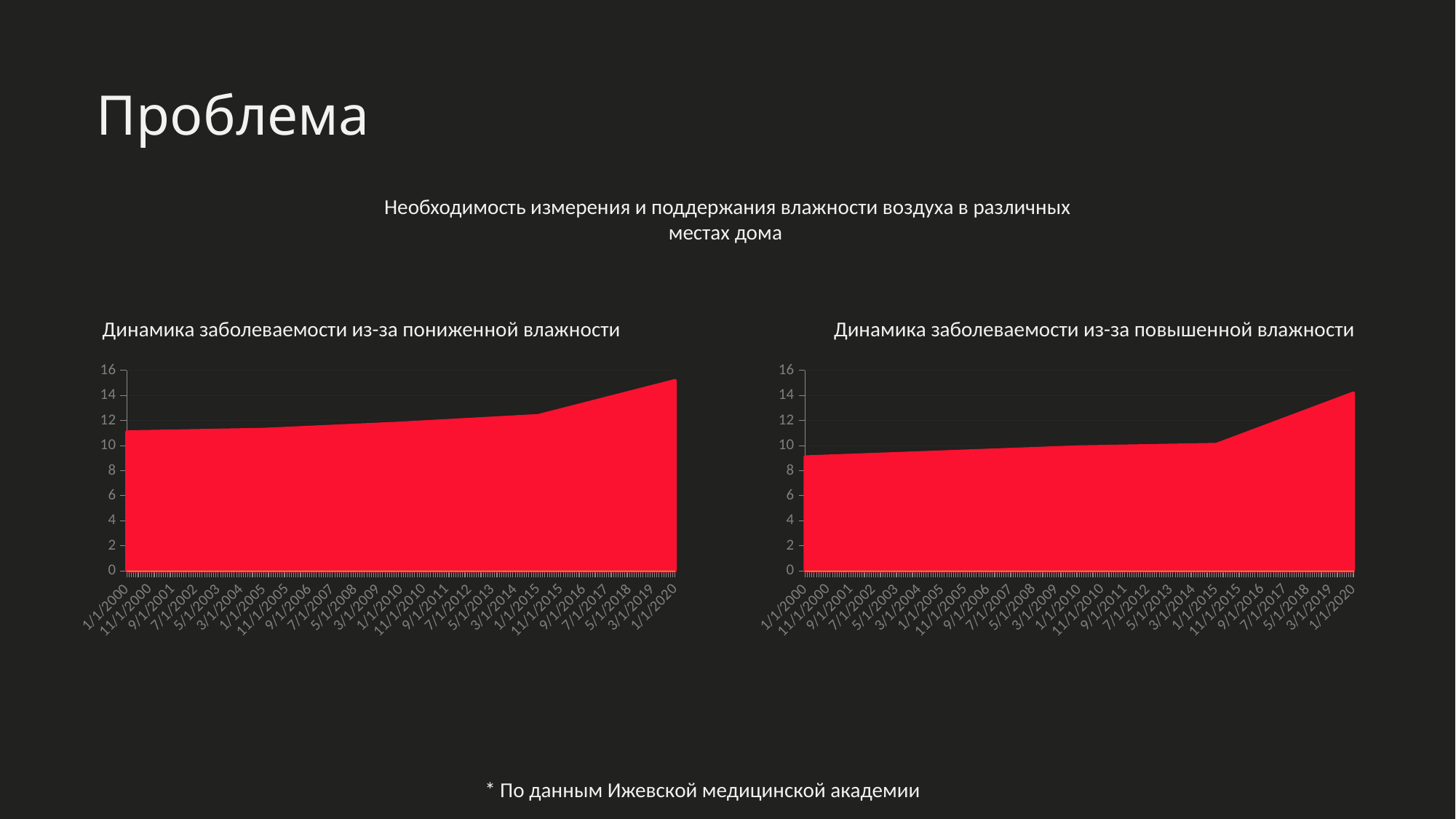
In the right chart 'Динамика заболеваемости из-за повышенной влажности', do the values rise or fall from 1/1/2000 to 1/1/2020? rise In the right chart 'Динамика заболеваемости из-за повышенной влажности', which date has the lowest value? 1/1/2000 In the left chart 'Динамика заболеваемости из-за пониженной влажности', do the values rise or fall from 1/1/2000 to 1/1/2020? rise In the right chart 'Динамика заболеваемости из-за повышенной влажности', which is larger: the value at 1/1/2000 or at 1/1/2020? 1/1/2020 What is the highest tick value on the y axis of the left chart 'Динамика заболеваемости из-за пониженной влажности'? 16 In the left chart 'Динамика заболеваемости из-за пониженной влажности', is the value at 1/1/2020 greater or less than 14? greater In the right chart 'Динамика заболеваемости из-за повышенной влажности', is the value at 1/1/2020 greater or less than 12? greater In the left chart 'Динамика заболеваемости из-за пониженной влажности', is the value at 1/1/2000 greater or less than 10? greater What kind of chart is the left chart, 'Динамика заболеваемости из-за пониженной влажности'? area chart What is the title of the right chart on the slide? Динамика заболеваемости из-за повышенной влажности In the left chart 'Динамика заболеваемости из-за пониженной влажности', which date has the highest value? 1/1/2020